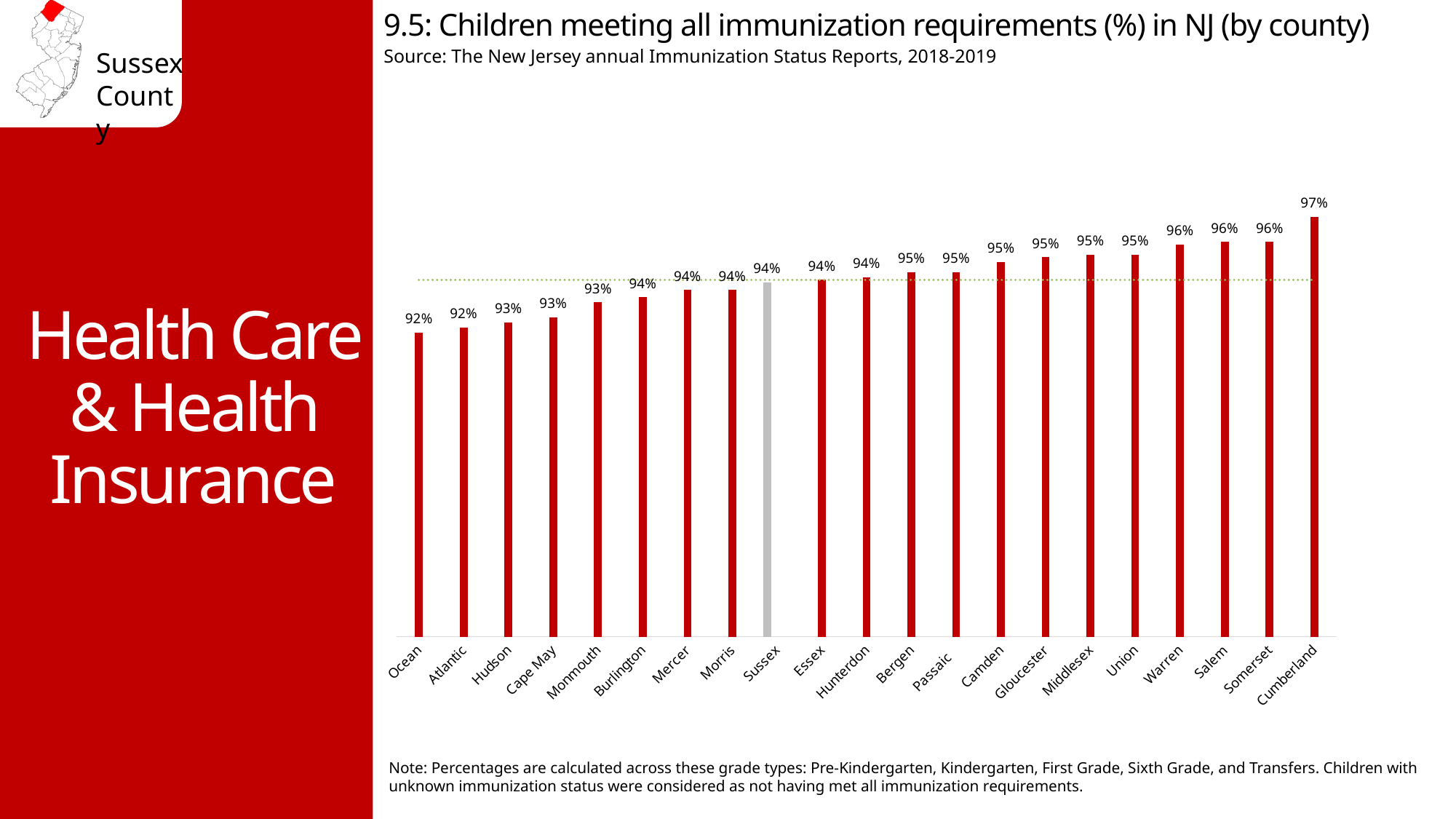
How many percentage points higher is Cumberland than Ocean? 5 What is the value shown for Cumberland County? 97% How many counties are shown on the chart? 21 What percentage is shown for Warren County? 96% Which county has the highest percentage of children meeting all immunization requirements? Cumberland What type of chart is used on this slide? Bar chart What is the lowest percentage value shown on the chart? 92% What is the value shown for Ocean County? 92% What is the difference in percentage points between Cumberland and Sussex? 3 Do the values rise or fall moving from left to right along the x axis? Rise Which has a higher value, Warren or Hudson? Warren What percentage of children in Sussex County met all immunization requirements? 94%